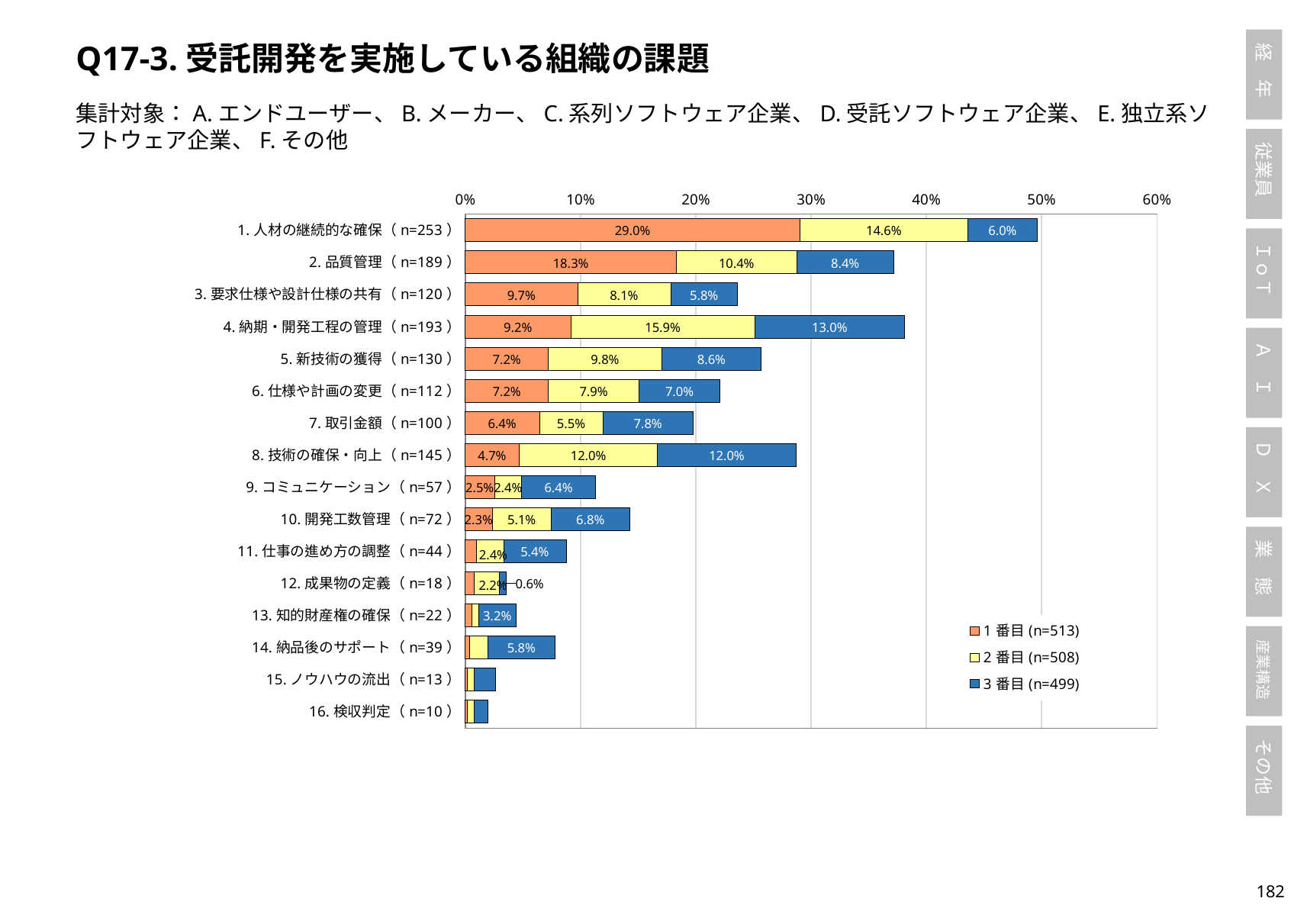
Is the total length of the stacked bar for 4. 納期・開発工程の管理 greater or less than 30%? greater What is the sample size (n) shown in the legend for the 2 番目 series? n=508 How many series does the legend list? 3 What is the value of the 2 番目 series for 8. 技術の確保・向上 (n=145)? 12.0% What is the difference between the 1 番目 values for 1. 人材の継続的な確保 and 2. 品質管理? 10.7 percentage points What kind of chart is shown on the slide? Stacked horizontal bar chart Which is larger: the 3 番目 value for 4. 納期・開発工程の管理 or for 2. 品質管理? 4. 納期・開発工程の管理 What is the total of the stacked bar for 2. 品質管理 (n=189)? 37.1% What is the value of the 3 番目 series for 4. 納期・開発工程の管理 (n=193)? 13.0% How many categories are shown on the chart? 16 What is the value of the 1 番目 series for 1. 人材の継続的な確保 (n=253)? 29.0% Which category has the highest value in the 1 番目 series? 1. 人材の継続的な確保 (n=253)